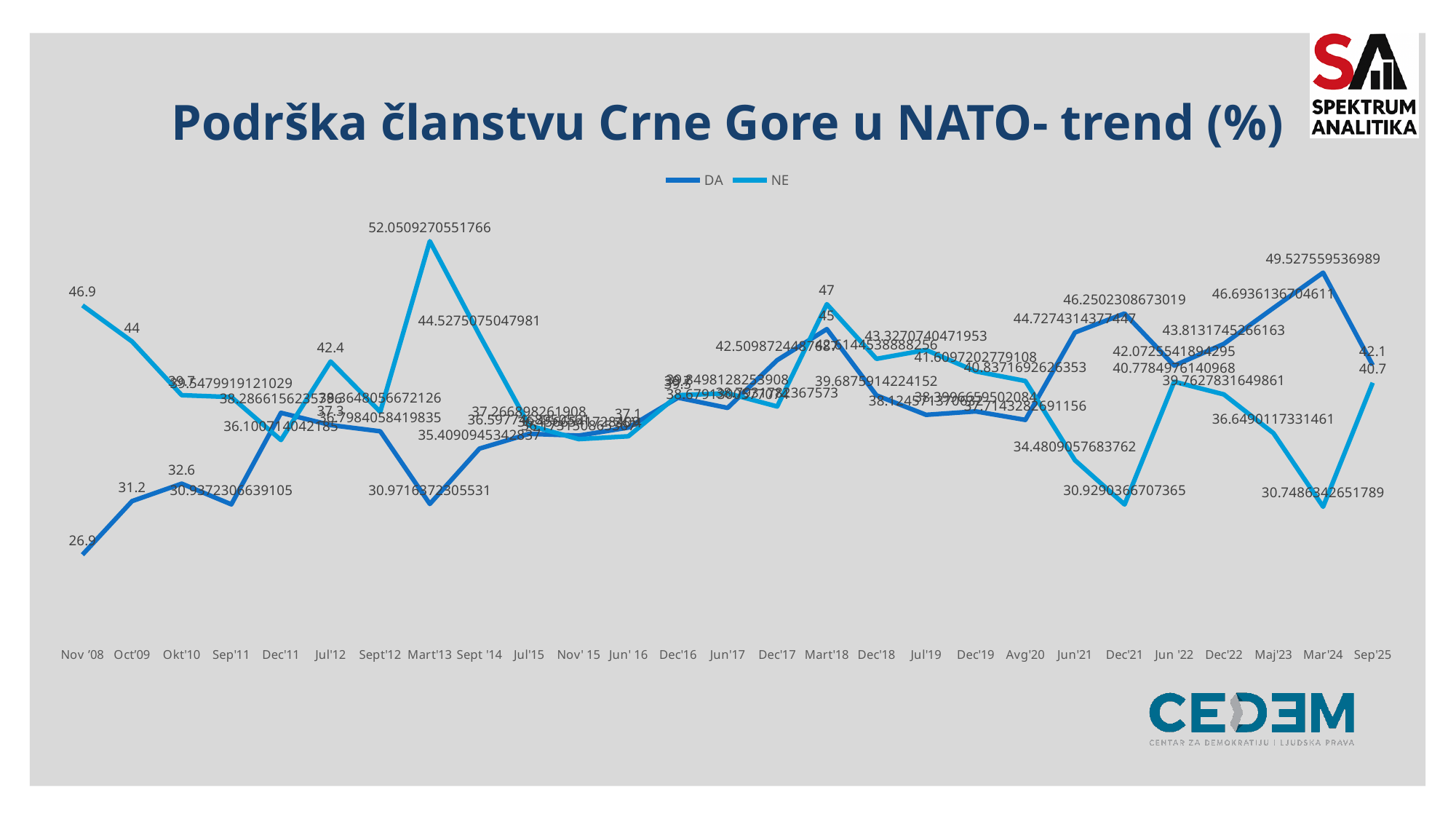
What is the value of the NE series at Mart'13? 52.0509270551766 At which time point does the DA series reach its highest value? Mar'24 Does the DA series rise or fall from Nov '08 to Okt'10? Rise How many series does the legend list? 2 What is the value of the DA series at Nov '08? 26.9 At which time point does the DA series have its lowest value? Nov '08 How many time points are shown on the x axis? 27 What is the value of the DA series at Sep'25? 42.1 What type of chart is shown on the slide? Line chart At Mar'24, which series has the larger value, DA or NE? DA What is the difference between the NE and DA values at Mart'18? 2 What are the names of the two series in the legend? DA and NE